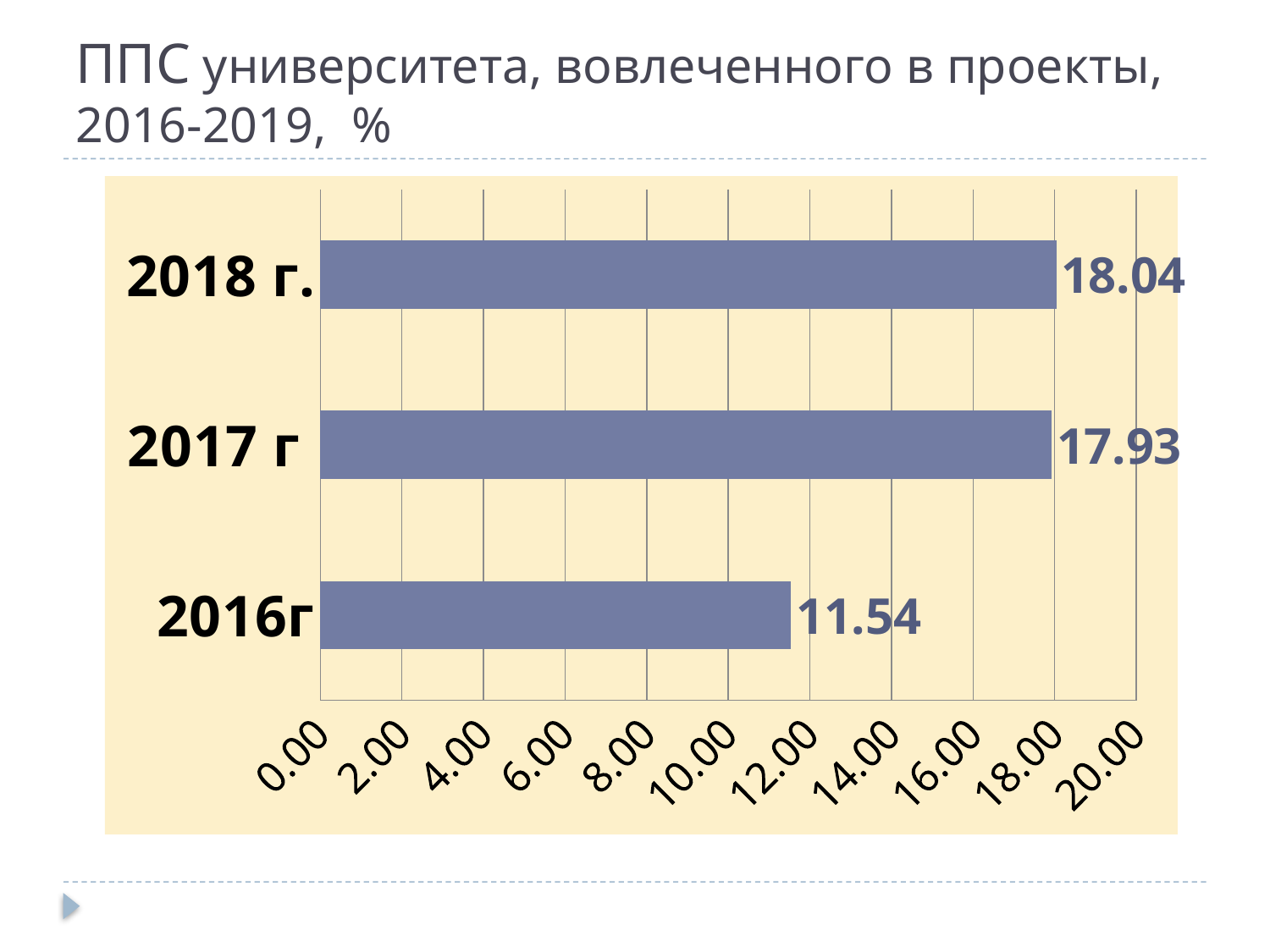
What kind of chart is shown on the slide? bar chart Which is larger, the value for 2017 г or the value for 2016г? 2017 г What is the value for 2018 г.? 18.04 What is the difference between the values for 2017 г and 2016г? 6.39 What is the maximum value shown on the horizontal axis? 20.00 What is the difference between the values for 2018 г. and 2016г? 6.50 What is the value for 2016г? 11.54 What is the value for 2017 г? 17.93 Which year has the highest value? 2018 г. How many categories are shown in the chart? 3 Which year has the lowest value? 2016г Is the value for 2016г greater or less than 10.00? greater